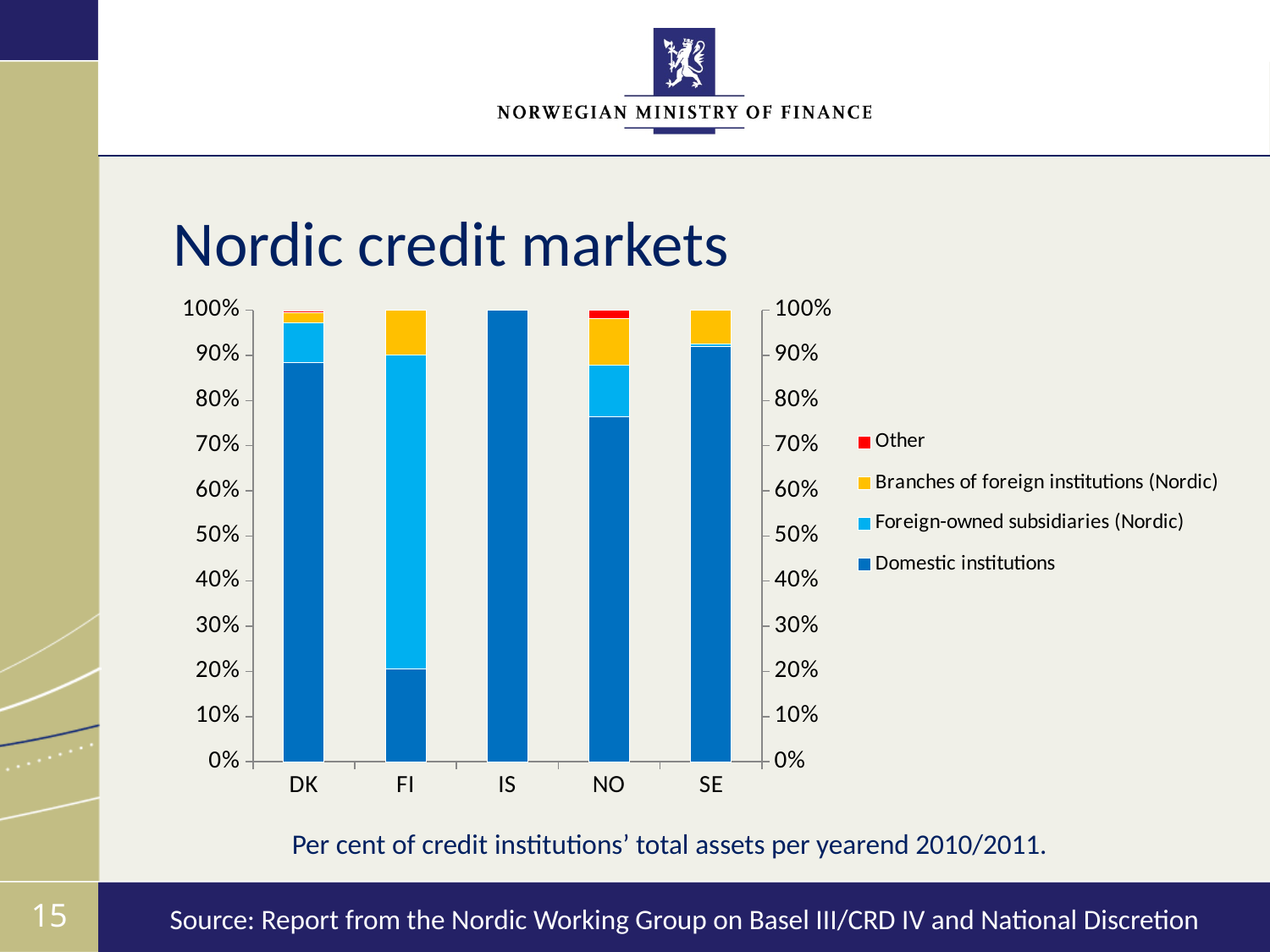
What is the total height of the stacked bar for IS? 100% Is the share of Domestic institutions for FI greater or less than 30%? less Which series is shown in red in the legend? Other Which country has the larger share of Foreign-owned subsidiaries (Nordic), FI or DK? FI Which country has the larger share of Domestic institutions, DK or NO? DK What is the title of the chart? Nordic credit markets How many countries are shown on the x axis of the chart? 5 How many series does the chart's legend list? 4 What kind of chart is shown on the slide? Stacked bar chart Which country has the lowest share of Domestic institutions? FI Is the share of Domestic institutions for NO greater or less than 70%? greater Which country has the highest share of Domestic institutions? IS